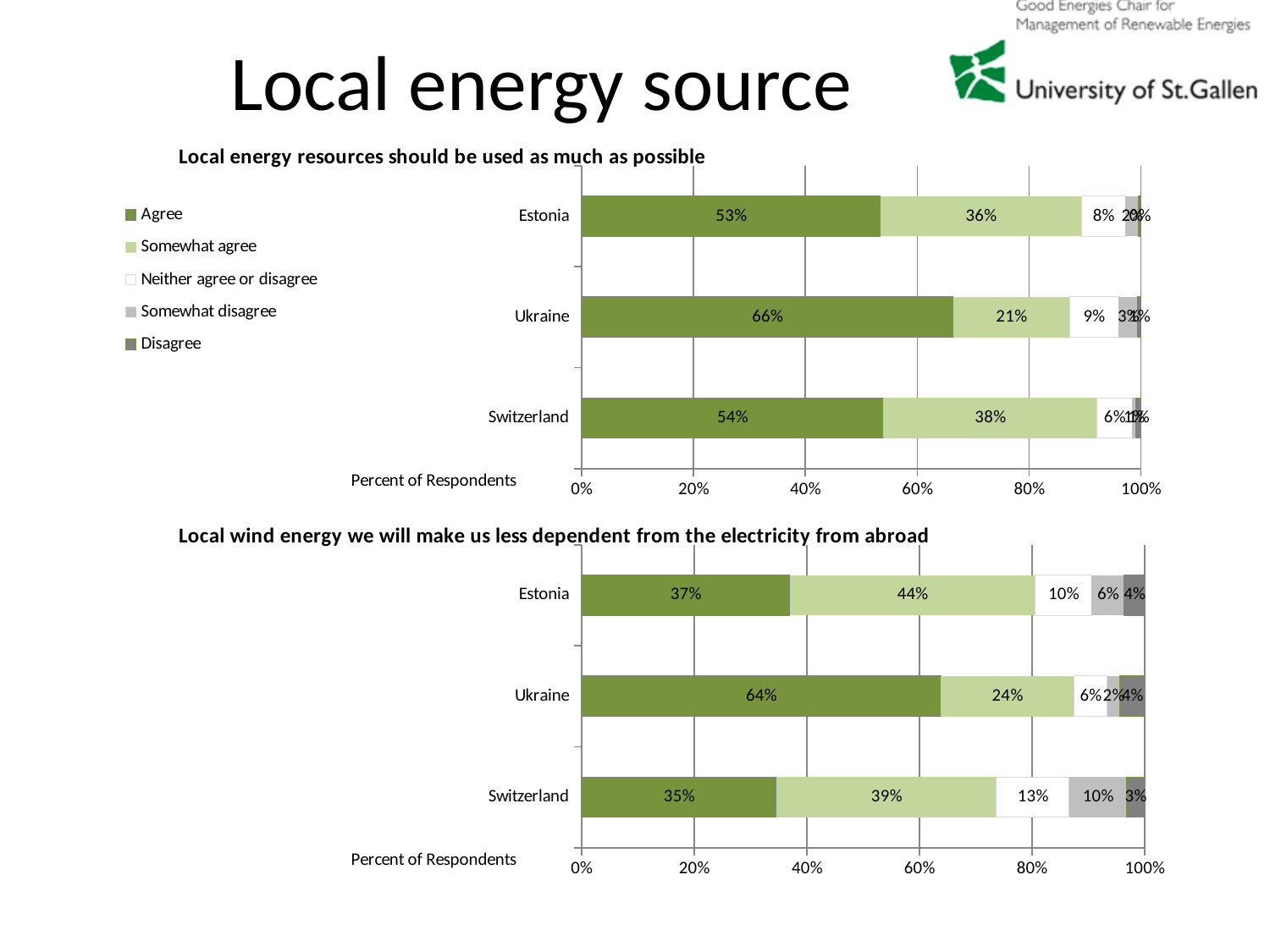
How many countries are shown in the chart titled 'Local energy resources should be used as much as possible'? 3 What type of chart is used for 'Local wind energy we will make us less dependent from the electricity from abroad'? Stacked bar chart How many series does the legend on the slide list? 5 In the chart titled 'Local energy resources should be used as much as possible', what percentage of Ukraine respondents chose 'Agree'? 66% In the chart titled 'Local wind energy we will make us less dependent from the electricity from abroad', is the 'Agree' share larger for Ukraine or for Estonia? Ukraine In the chart titled 'Local energy resources should be used as much as possible', which country has the highest 'Agree' share? Ukraine In the chart titled 'Local energy resources should be used as much as possible', what is the difference between the 'Agree' shares of Ukraine and Estonia? 13 percentage points In the chart titled 'Local wind energy we will make us less dependent from the electricity from abroad', what percentage of Switzerland respondents chose 'Neither agree or disagree'? 13% In the chart titled 'Local energy resources should be used as much as possible', what percentage of Switzerland respondents chose 'Somewhat agree'? 38% In the chart titled 'Local wind energy we will make us less dependent from the electricity from abroad', what percentage of Estonia respondents chose 'Somewhat agree'? 44% In the chart titled 'Local wind energy we will make us less dependent from the electricity from abroad', what is the difference between the 'Somewhat disagree' shares of Switzerland and Estonia? 4 percentage points In the chart titled 'Local wind energy we will make us less dependent from the electricity from abroad', which country has the lowest 'Agree' share? Switzerland